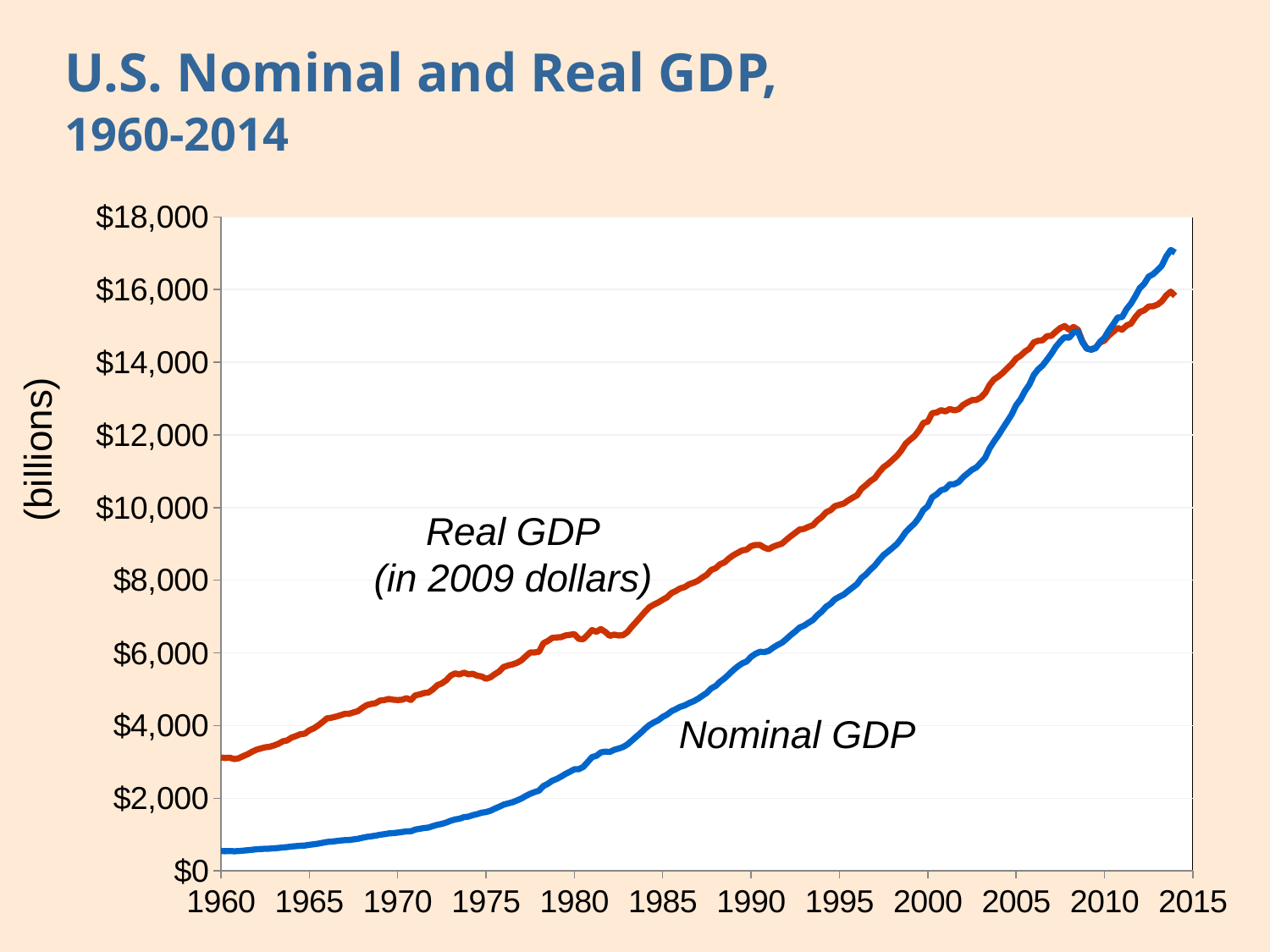
Is the value for Nominal GDP in 1960 greater or less than $2,000? less Is the value for Nominal GDP in 1980 greater or less than $4,000? less Which series is drawn with the blue line? Nominal GDP In 2014, which series has the higher value, Real GDP or Nominal GDP? Nominal GDP What kind of chart is shown on the slide? line chart In 1960, which series has the higher value, Real GDP or Nominal GDP? Real GDP Is the value for Real GDP in 1960 greater or less than $2,000? greater How many data series are plotted on the chart? 2 Does Nominal GDP generally rise or fall from 1960 to 2014? rise What is the title of the chart? U.S. Nominal and Real GDP, 1960-2014